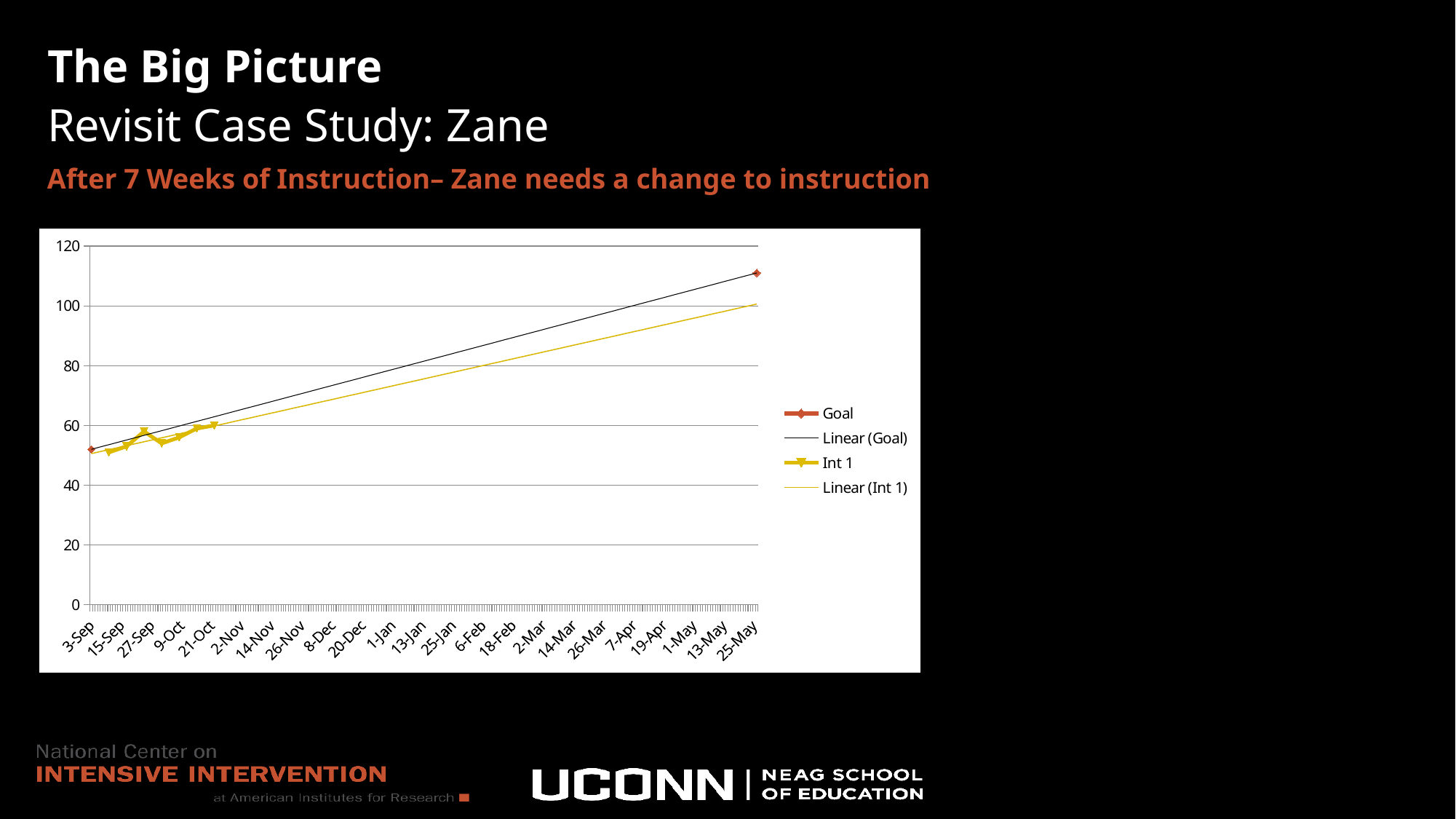
Do the Int 1 values generally rise or fall from 3-Sep to 21-Oct? rise What kind of chart is shown on the slide? line chart Is the last Int 1 data point (around 21-Oct) greater or less than 40? greater What are the four entries in the chart legend? Goal, Linear (Goal), Int 1, Linear (Int 1) Are the Int 1 data points greater or less than 80? less Does the Linear (Goal) trendline rise or fall from 3-Sep to 25-May? rise What colour is the Int 1 series line? yellow Which is larger: the Goal value at 25-May or the last Int 1 value around 21-Oct? Goal value at 25-May Is the value of the Goal series at 25-May greater or less than 100? greater How many series does the chart legend list? 4